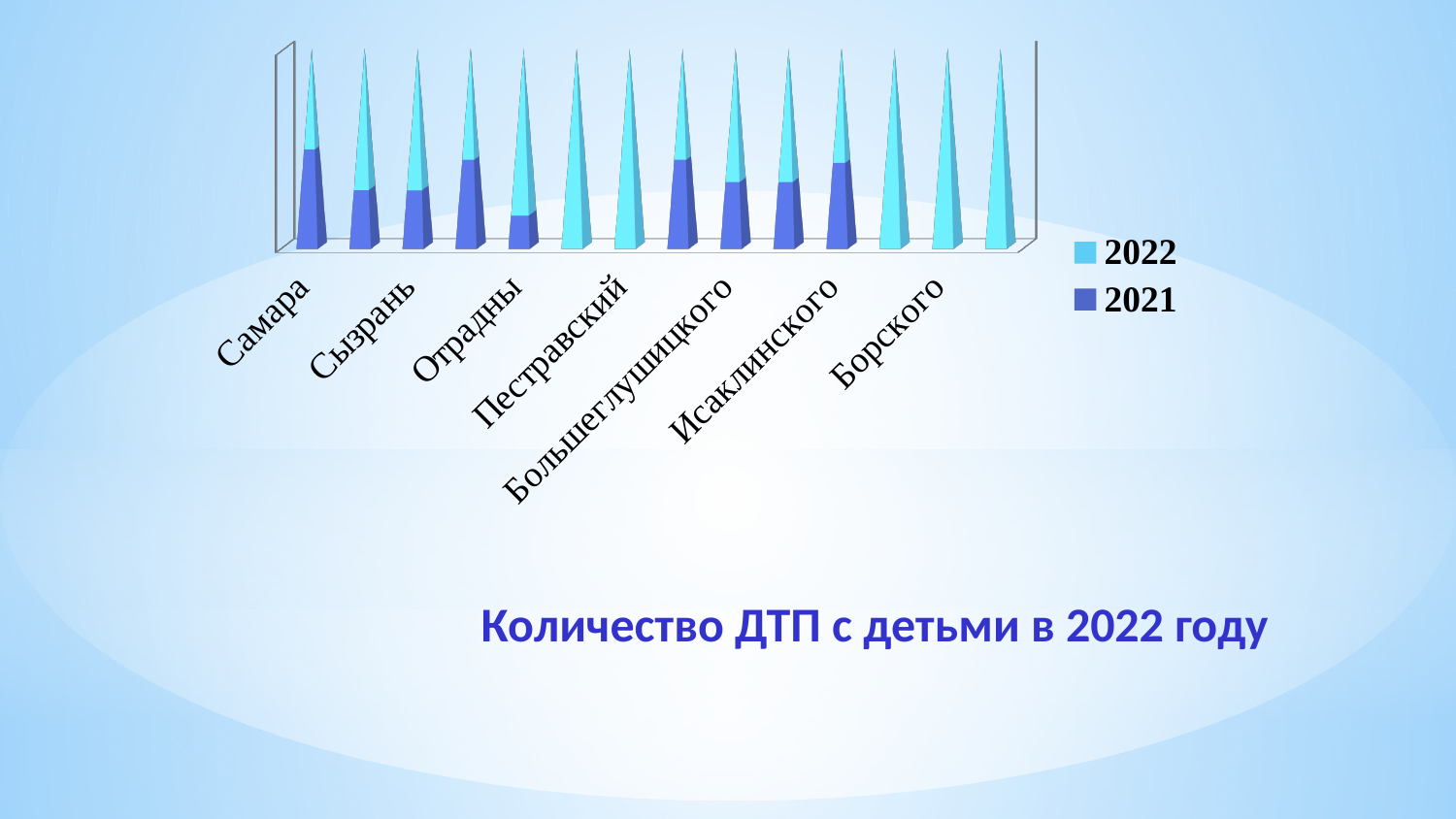
How many series does the legend list? 2 What caption is printed below the chart? Количество ДТП с детьми в 2022 году Which is larger, the 2021 value for Отрадны or the 2021 value for Сызрань? Сызрань What are the two series named in the legend? 2022 and 2021 What kind of chart is shown on the slide? bar chart Which is larger, the 2021 value for Самара or the 2021 value for Сызрань? Самара How many category labels are shown along the x axis? 7